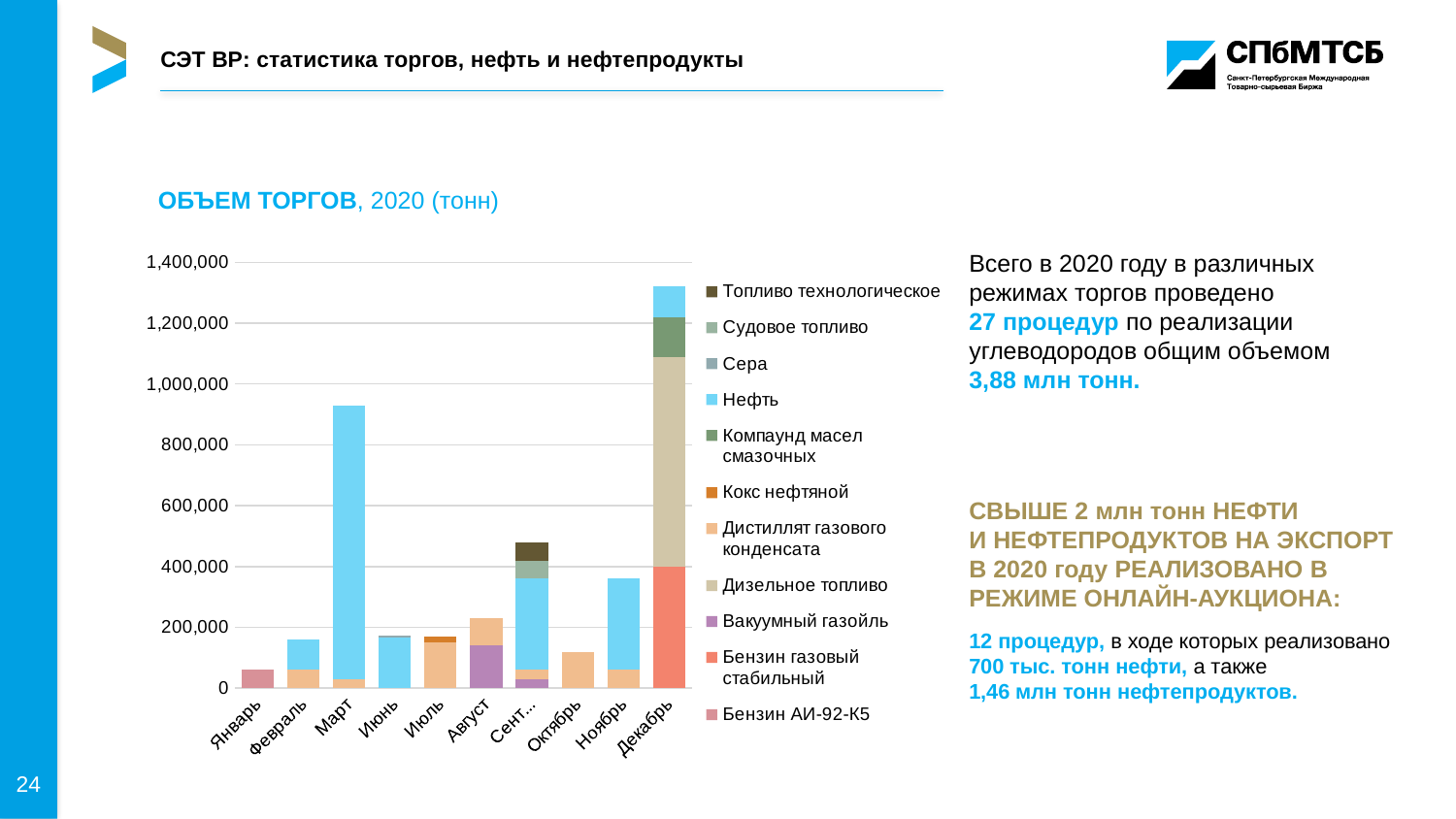
Which series in the legend is shown in light blue? Нефть How many series does the chart legend list? 11 Which month has the lowest total trading volume in the chart? Январь What is the title of the chart? ОБЪЕМ ТОРГОВ, 2020 (тонн) How many months (categories) are shown on the x axis of the chart? 10 Is the total value for Декабрь greater or less than 1,200,000? greater Which month has the highest total trading volume in the chart? Декабрь Is the total value for Январь greater or less than 200,000? less Which month has a larger total trading volume, Март or Ноябрь? Март Is the total value for Март greater or less than 800,000? greater What kind of chart is shown on the slide? Stacked bar chart